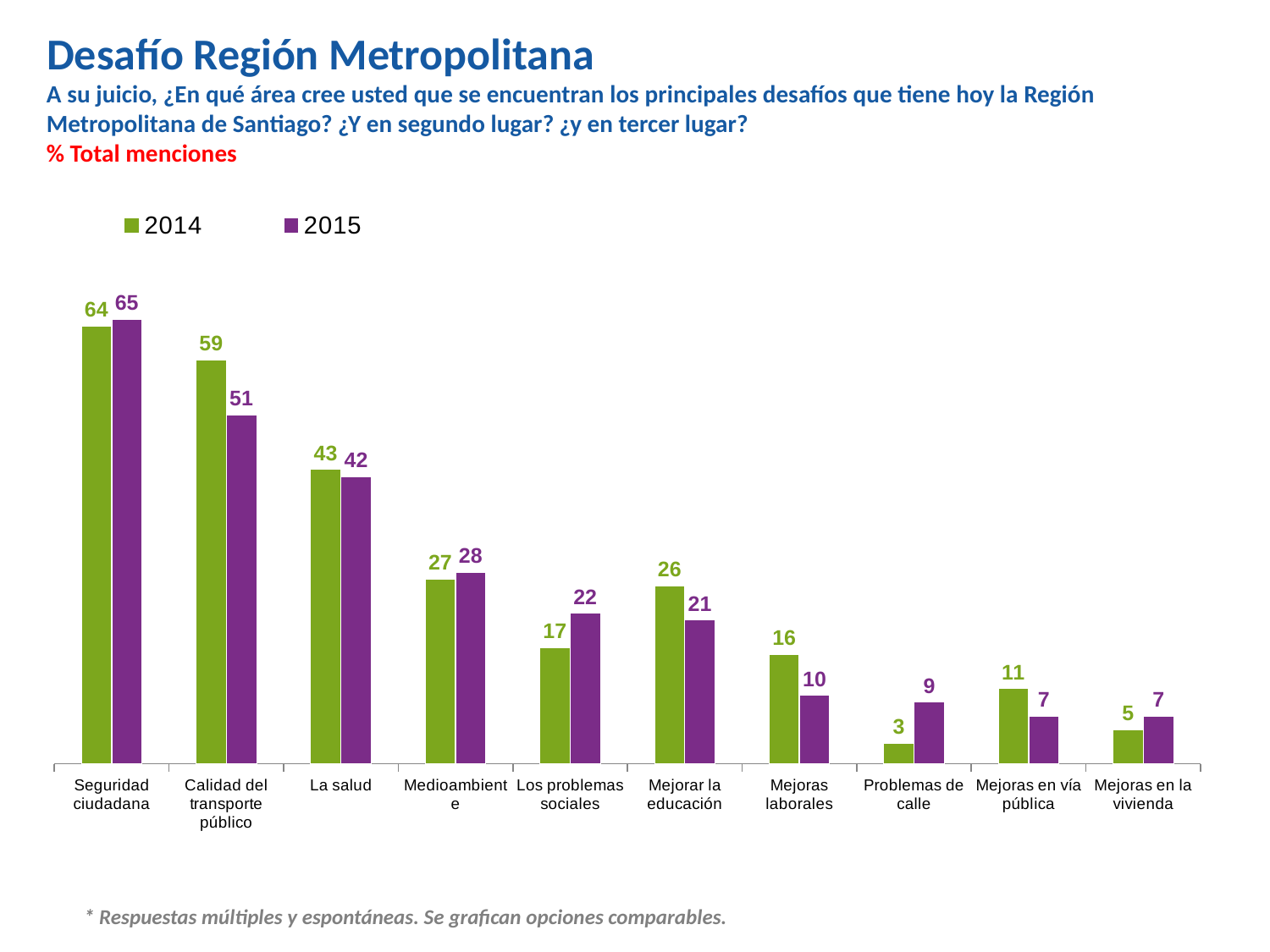
Which category has the highest 2014 value? Seguridad ciudadana How many series does the legend list? 2 What is the 2015 value for Los problemas sociales? 22 What is the 2015 value for Seguridad ciudadana? 65 Which colour represents the 2015 series in the legend? Purple Which is larger for Mejoras laborales, the 2014 value or the 2015 value? 2014 What is the difference between the 2014 and 2015 values for Calidad del transporte público? 8 What is the 2014 value for Calidad del transporte público? 59 Which category has the lowest 2015 value? Mejoras en vía pública and Mejoras en la vivienda (both 7) How many categories are shown on the x axis? 10 What kind of chart is shown on the slide? Bar chart What is the 2014 value for Problemas de calle? 3